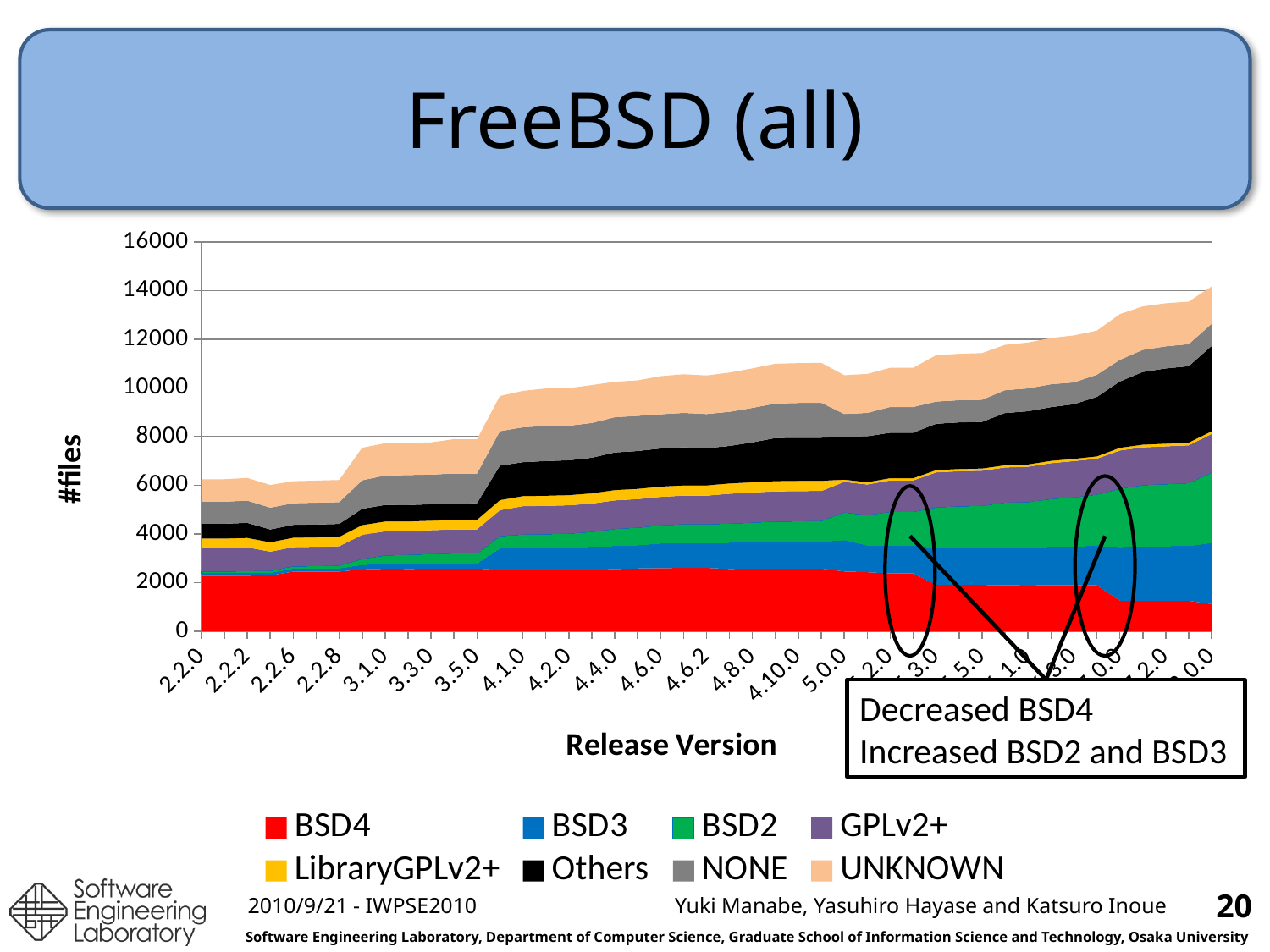
Is the number of BSD4 files at the rightmost release version greater or less than 2000? less Is the total number of files at release 2.2.0 greater or less than 8000? less What kind of chart is shown on the slide? Stacked area chart Is the total number of files at the rightmost release version greater or less than 12000? greater What is the title of the chart? FreeBSD (all) Does the total number of files rise or fall as the release version increases along the x axis? rise How many series does the legend list? 8 At release 2.2.0, which series has more files, BSD4 or BSD3? BSD4 What is the label of the vertical axis? #files At the rightmost release version, which series has more files, BSD2 or BSD4? BSD2 Does the number of BSD4 files rise or fall over the last several release versions on the right of the chart? fall